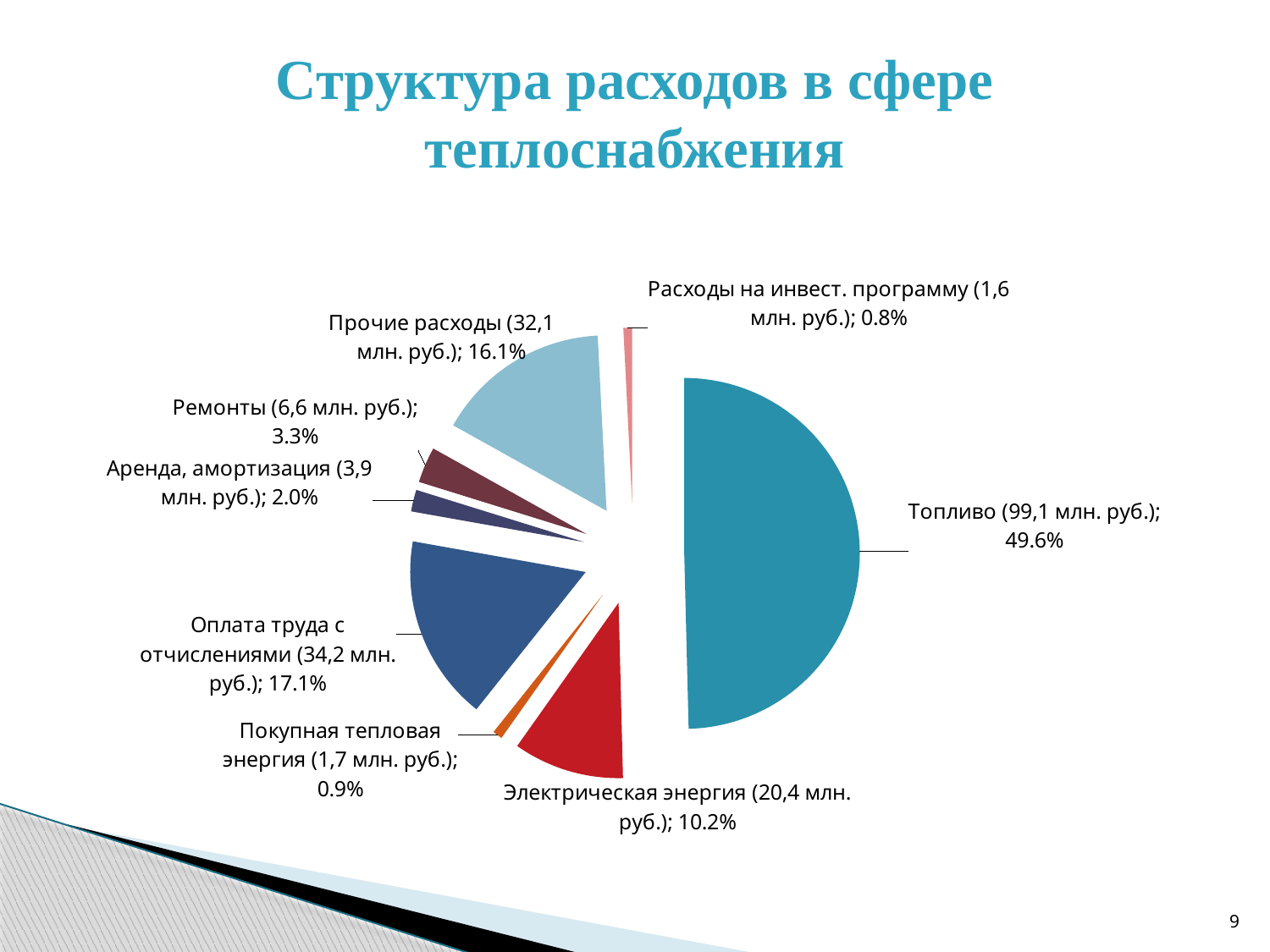
What is the difference in percentage points between Оплата труда с отчислениями and Прочие расходы? 1.0% Which category has the smallest share of the pie? Расходы на инвест. программу What kind of chart is shown on the slide? pie chart Which is larger: the share for Ремонты or the share for Аренда, амортизация? Ремонты What is the value shown for Оплата труда с отчислениями? 34,2 млн. руб. Which category has the largest share of the pie? Топливо What is the title of the chart on the slide? Структура расходов в сфере теплоснабжения How many slices does the pie chart have? 8 What share of expenses does Топливо account for? 49.6% What percentage is shown for Электрическая энергия? 10.2% What is the value shown for Прочие расходы? 32,1 млн. руб. What percentage is shown for Покупная тепловая энергия? 0.9%